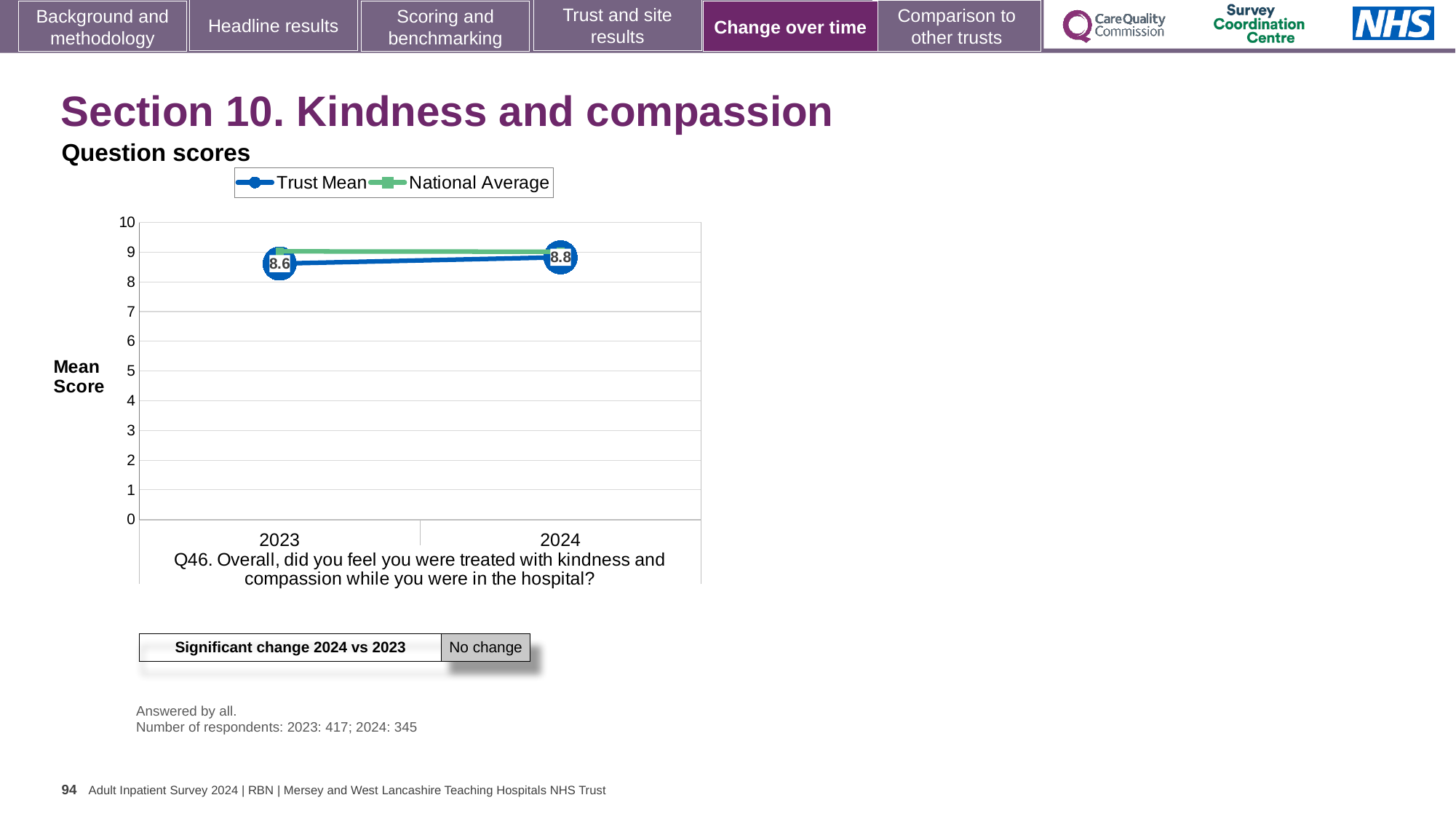
How many years are plotted on the x axis? 2 How many series does the legend list? 2 In 2023, which is higher: the Trust Mean or the National Average? National Average What is the Trust Mean score for 2023? 8.6 What kind of chart is shown on the slide? line chart By how much did the Trust Mean score change from 2023 to 2024? 0.2 What is the label of the y axis? Mean Score Does the Trust Mean line rise or fall from 2023 to 2024? rise What is the Trust Mean score for 2024? 8.8 Which year has the higher Trust Mean score, 2023 or 2024? 2024 Is the National Average value for 2023 greater or less than 8? greater What is the maximum value shown on the y axis? 10